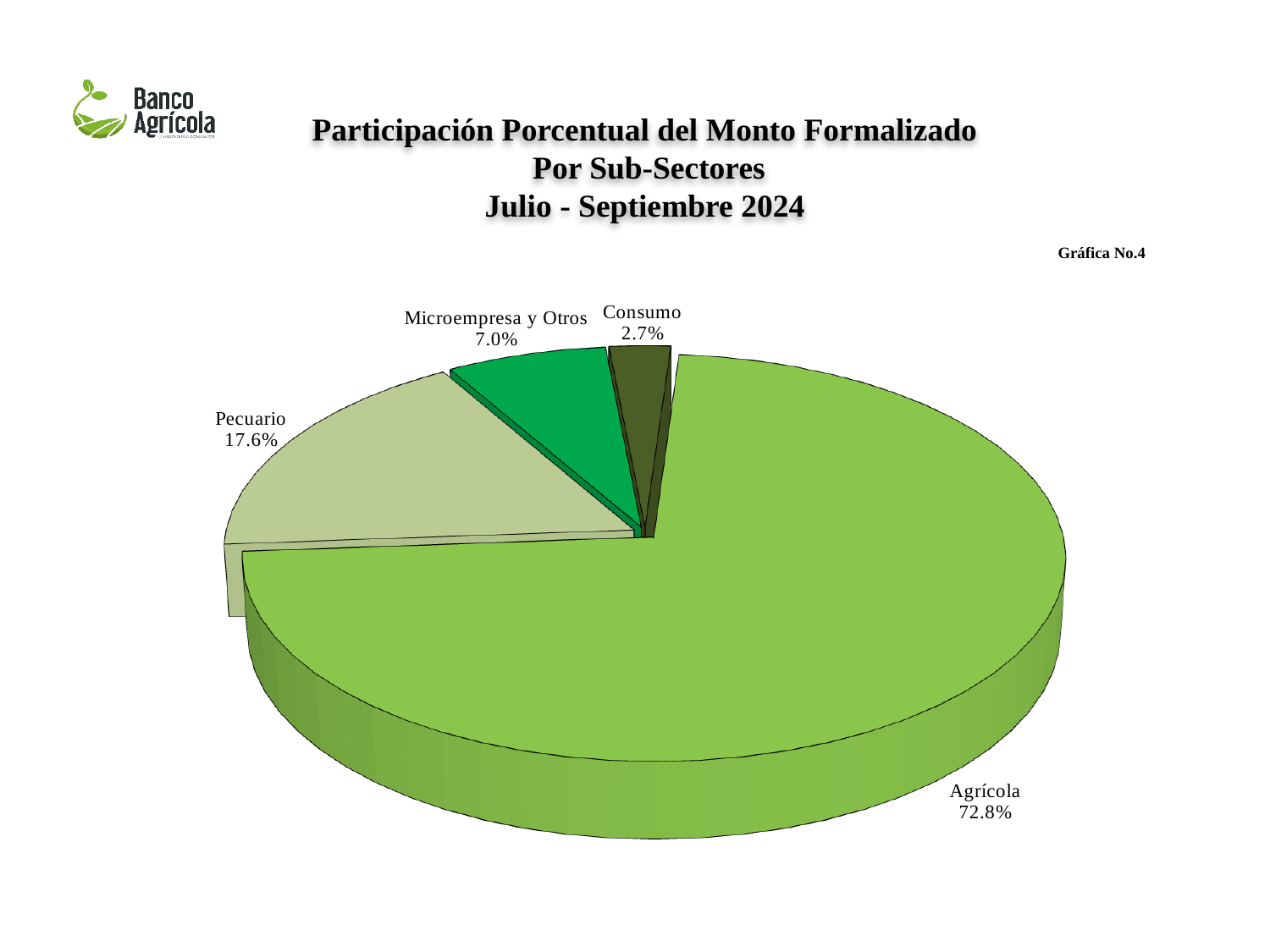
What kind of chart is shown on the slide? Pie chart Which sub-sector has the largest share? Agrícola What period does the chart title refer to? Julio - Septiembre 2024 Which is larger, Microempresa y Otros or Consumo? Microempresa y Otros What is the difference in percentage points between Agrícola and Pecuario? 55.2 What is the value shown for Consumo? 2.7% What is the value shown for Microempresa y Otros? 7.0% How many sub-sectors are shown in the pie chart? 4 What share of the pie does Agrícola represent? 72.8% What is the difference in percentage points between Pecuario and Microempresa y Otros? 10.6 What is the value shown for Pecuario? 17.6% Which sub-sector has the smallest share? Consumo